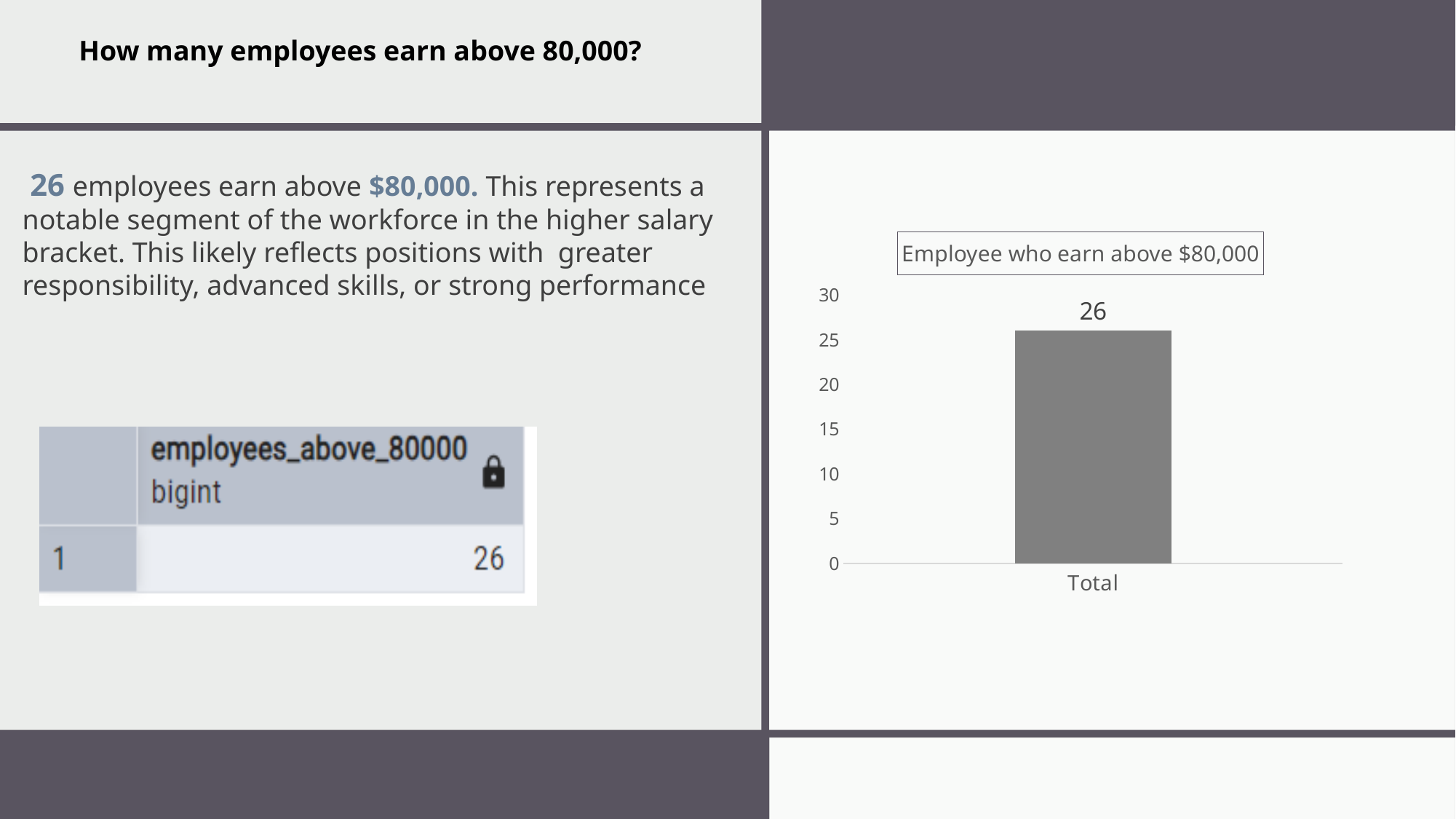
What kind of chart is shown on the slide? bar chart Is the value for Total greater or less than 20? greater Is the value for Total greater or less than 30? less How many bars does the chart have? 1 What is the label of the category on the x axis of the chart? Total What is the highest value shown on the chart's vertical axis? 30 What is the title of the chart? Employee who earn above $80,000 What is the value of the Total bar in the chart? 26